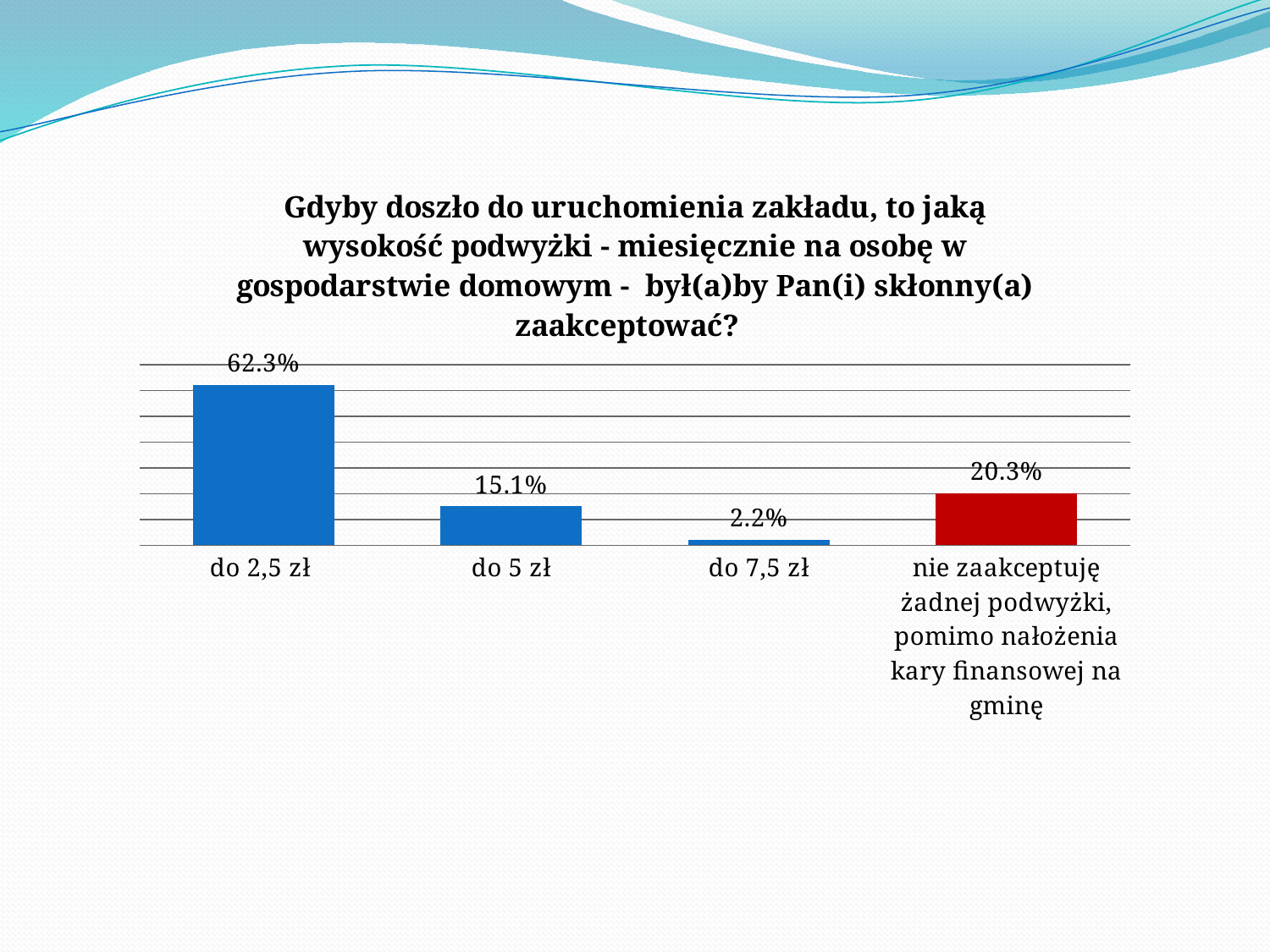
What is the value for "nie zaakceptuję żadnej podwyżki, pomimo nałożenia kary finansowej na gminę"? 20.3% What is the value for "do 5 zł"? 15.1% How many categories are shown in the chart? 4 What is the value for "do 7,5 zł"? 2.2% Which category has the highest value? do 2,5 zł What is the difference between the values for "do 2,5 zł" and "do 5 zł"? 47.2% What is the value for "do 2,5 zł"? 62.3% Which category has the lowest value? do 7,5 zł Which is larger: the value for "do 5 zł" or the value for "nie zaakceptuję żadnej podwyżki, pomimo nałożenia kary finansowej na gminę"? nie zaakceptuję żadnej podwyżki, pomimo nałożenia kary finansowej na gminę What is the difference between the values for "nie zaakceptuję żadnej podwyżki, pomimo nałożenia kary finansowej na gminę" and "do 5 zł"? 5.2% What colour is the bar for "nie zaakceptuję żadnej podwyżki, pomimo nałożenia kary finansowej na gminę"? red What kind of chart is shown on the slide? bar chart